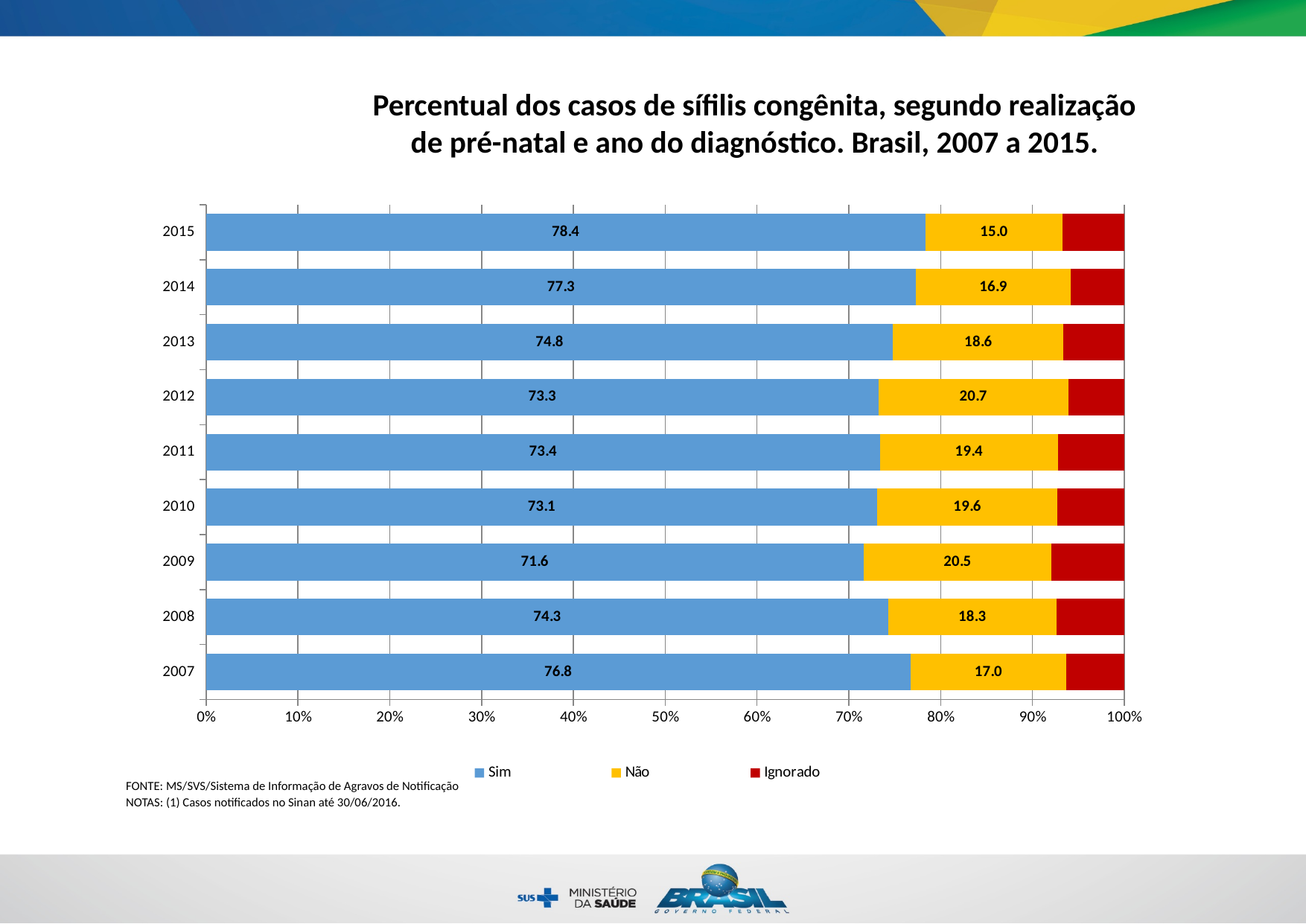
What is the value of the Não series for 2007? 17.0 What kind of chart is shown on the slide? Stacked bar chart What is the value of the Sim series for 2009? 71.6 How many years are shown on the chart? 9 Which year has the highest value for the Sim series? 2015 Which year has the lowest value for the Sim series? 2009 How many series does the legend list? 3 Which year has the lowest value for the Não series? 2015 What is the value of the Sim series for 2015? 78.4 What is the difference between the Sim values for 2015 and 2007? 1.6 What is the value of the Não series for 2012? 20.7 Which is larger, the Sim value for 2008 or for 2009? 2008